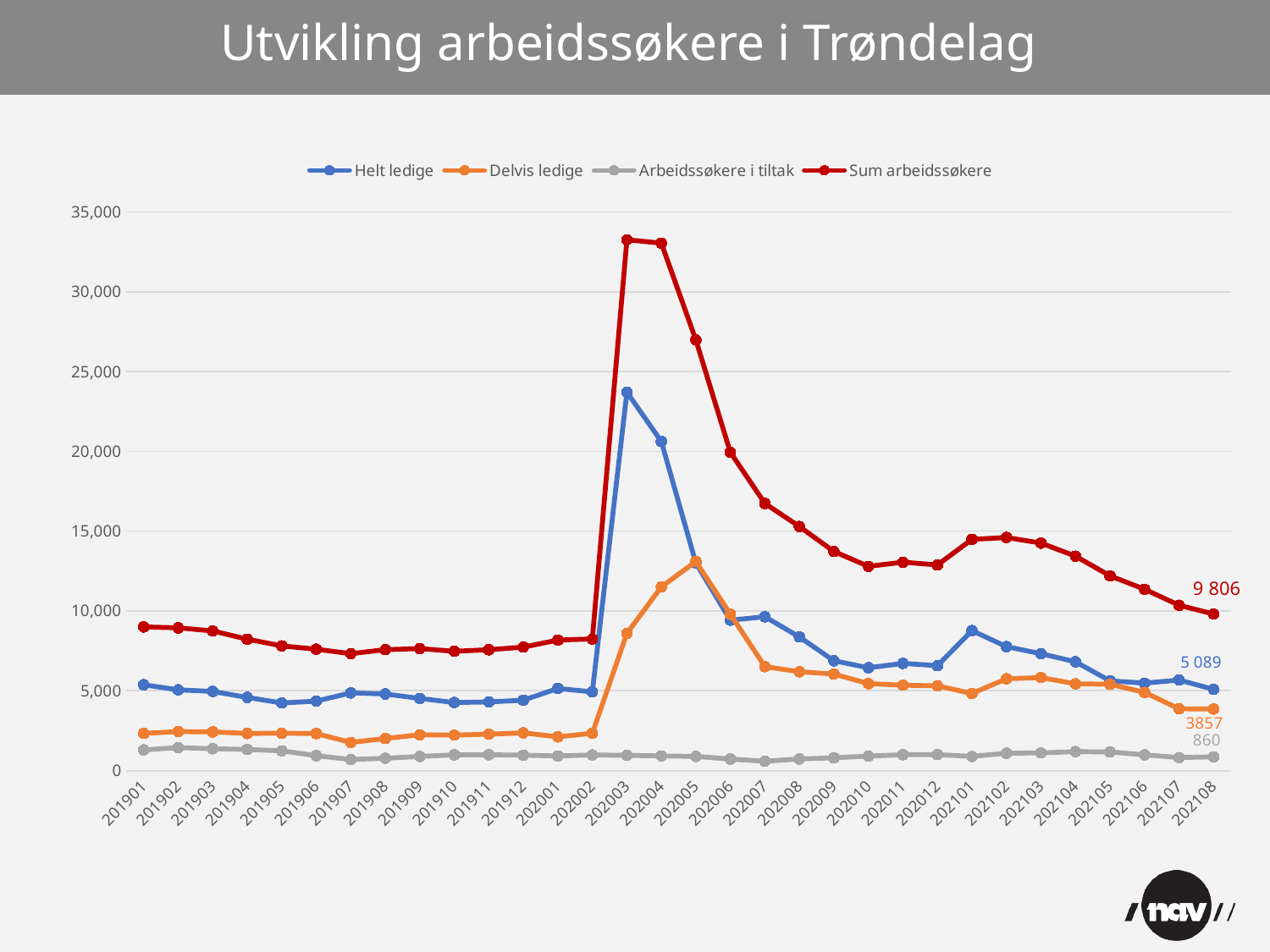
Is the value of Helt ledige at 202003 greater or less than 20,000? greater Is the value of Sum arbeidssøkere at 202003 greater or less than 30,000? greater What kind of chart is shown on the slide? line chart How many series does the legend list? 4 What is the difference between Delvis ledige and Arbeidssøkere i tiltak at 202108? 2997 What is the value of Helt ledige at 202108? 5 089 In which period does Delvis ledige reach its highest value? 202005 In which period does Sum arbeidssøkere reach its highest value? 202003 Does Sum arbeidssøkere rise or fall from 202102 to 202108? fall What is the value of Arbeidssøkere i tiltak at 202108? 860 What is the value of Sum arbeidssøkere at 202108? 9 806 What is the value of Delvis ledige at 202108? 3857